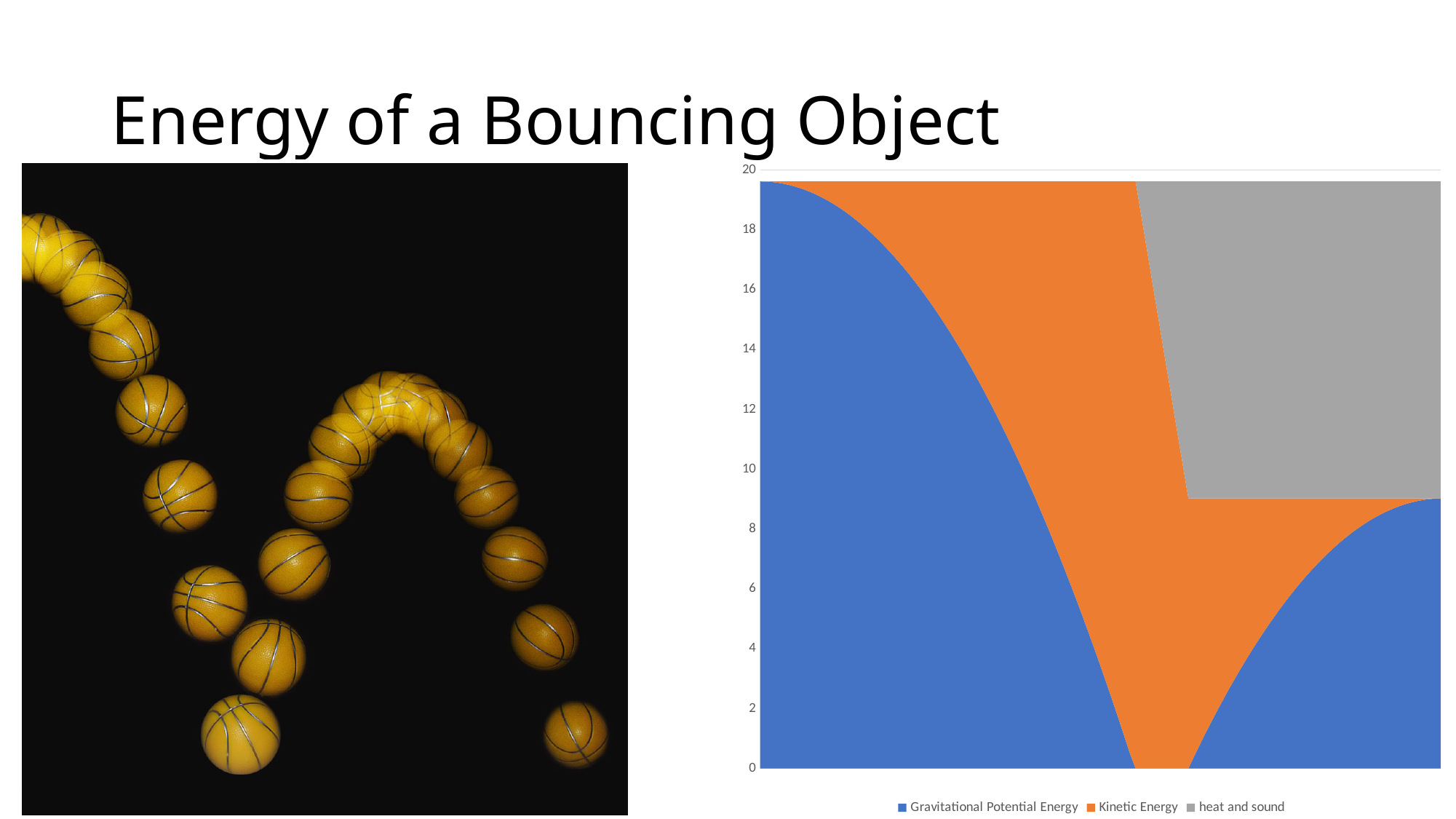
Does the Gravitational Potential Energy area fall or rise from the left edge of the chart toward the middle? fall Which series is shown in orange in the chart? Kinetic Energy How many series does the legend of the chart list? 3 At the right edge of the chart, which series is larger: heat and sound or Kinetic Energy? heat and sound At the right edge of the chart, is the Gravitational Potential Energy value greater or less than 10? less Which series is shown in grey in the chart? heat and sound Is the top of the stacked area at the left edge of the chart greater or less than 18? greater What is the highest tick value shown on the vertical axis of the chart? 20 Does the Gravitational Potential Energy area fall or rise from the middle of the chart toward the right edge? rise At the left edge of the chart, which series is larger: Gravitational Potential Energy or Kinetic Energy? Gravitational Potential Energy What kind of chart is shown on the right of the slide? Stacked area chart At the right edge of the chart, is the Gravitational Potential Energy value greater or less than 8? greater